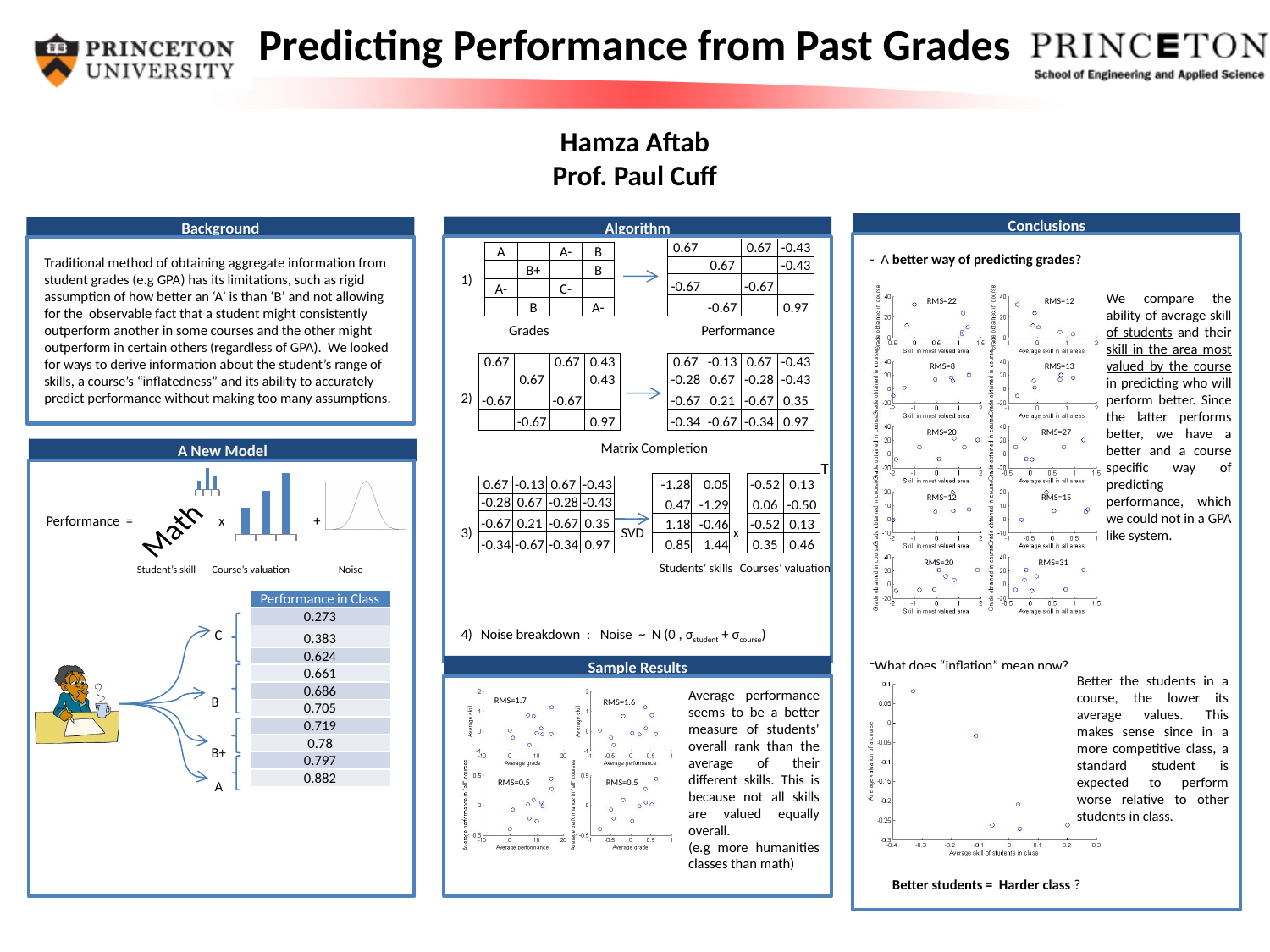
What kind of charts are shown in the Sample Results panel? Scatter plots In the bottom scatter plot of the Conclusions panel, do the points rise or fall as the average skill of students in class increases? Fall In the Sample Results panel, what RMS value is printed on the bottom-left scatter plot? 0.5 In the Sample Results panel, what RMS value is printed on the top-left scatter plot? 1.7 How many scatter plots are shown in the Sample Results panel? 4 In the Conclusions panel grid of scatter plots, what is the lowest RMS value printed? 8 In the Conclusions panel grid of scatter plots, what is the difference between the RMS values of the top-left plot and the top-right plot? 10 In the Sample Results panel, which has the larger RMS value, the top-left plot or the top-right plot? Top-left plot How many scatter plots are in the grid of plots under 'A better way of predicting grades?' in the Conclusions panel? 10 In the Conclusions panel grid of scatter plots, what RMS value is printed on the top-left plot? 22 In the Conclusions panel grid of scatter plots, what is the highest RMS value printed? 31 In the Sample Results panel, what RMS value is printed on the top-right scatter plot? 1.6